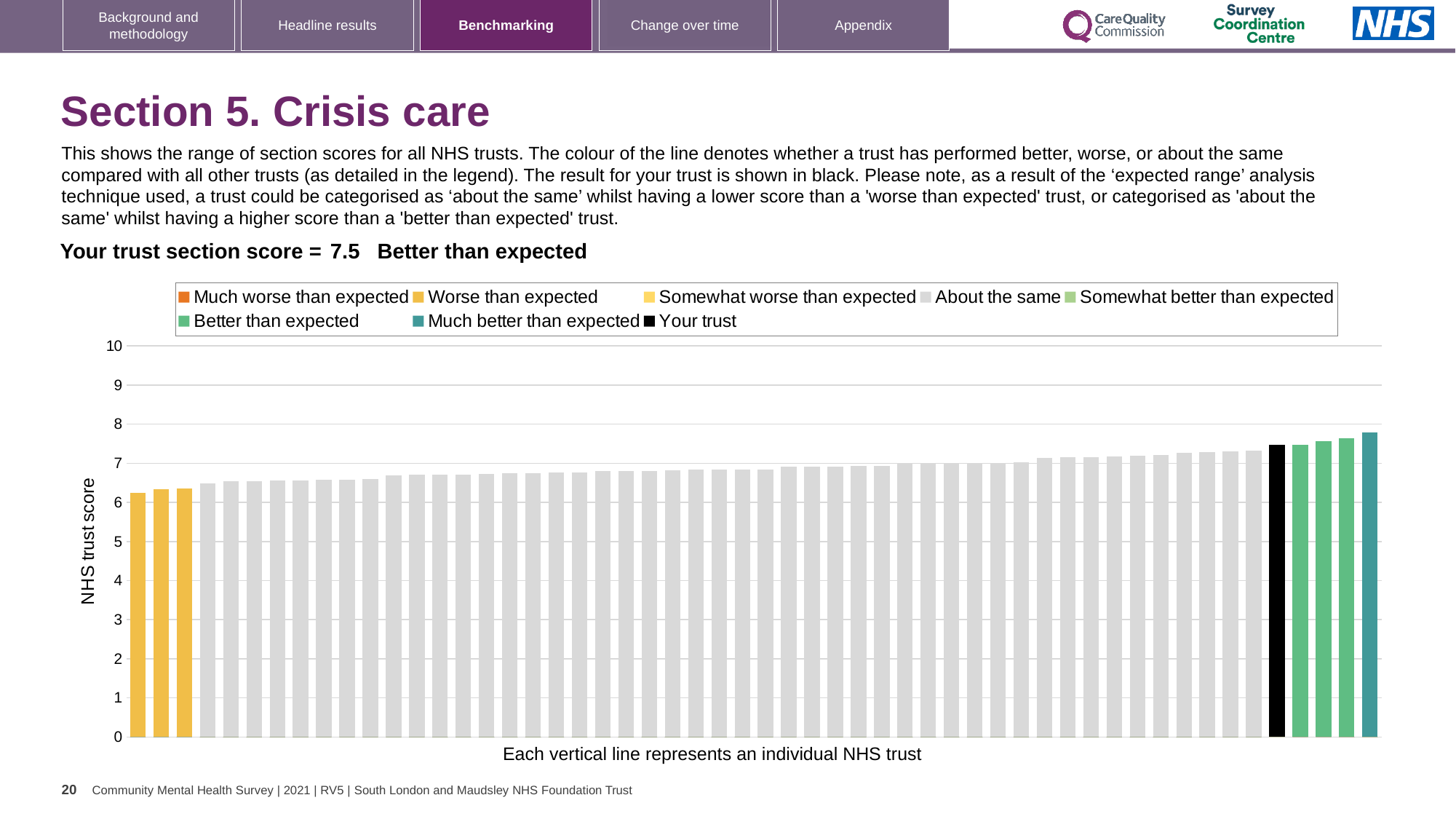
Is the value of the leftmost bar greater or less than 7? less What colour is used for the 'Your trust' bar in the chart? black Which legend category does the shortest bar belong to? Worse than expected What is the section score for your trust shown on the slide? 7.5 What is the label on the vertical axis of the chart? NHS trust score Is the value of the black 'Your trust' bar greater or less than 7? greater Do the bar values rise or fall from left to right along the x axis? rise Which legend category does the tallest bar belong to? Much better than expected Which performance category is your trust placed in for crisis care? Better than expected How many entries does the chart legend list? 8 What kind of chart is shown on the slide? bar chart Is the value of the tallest bar greater or less than 8? less